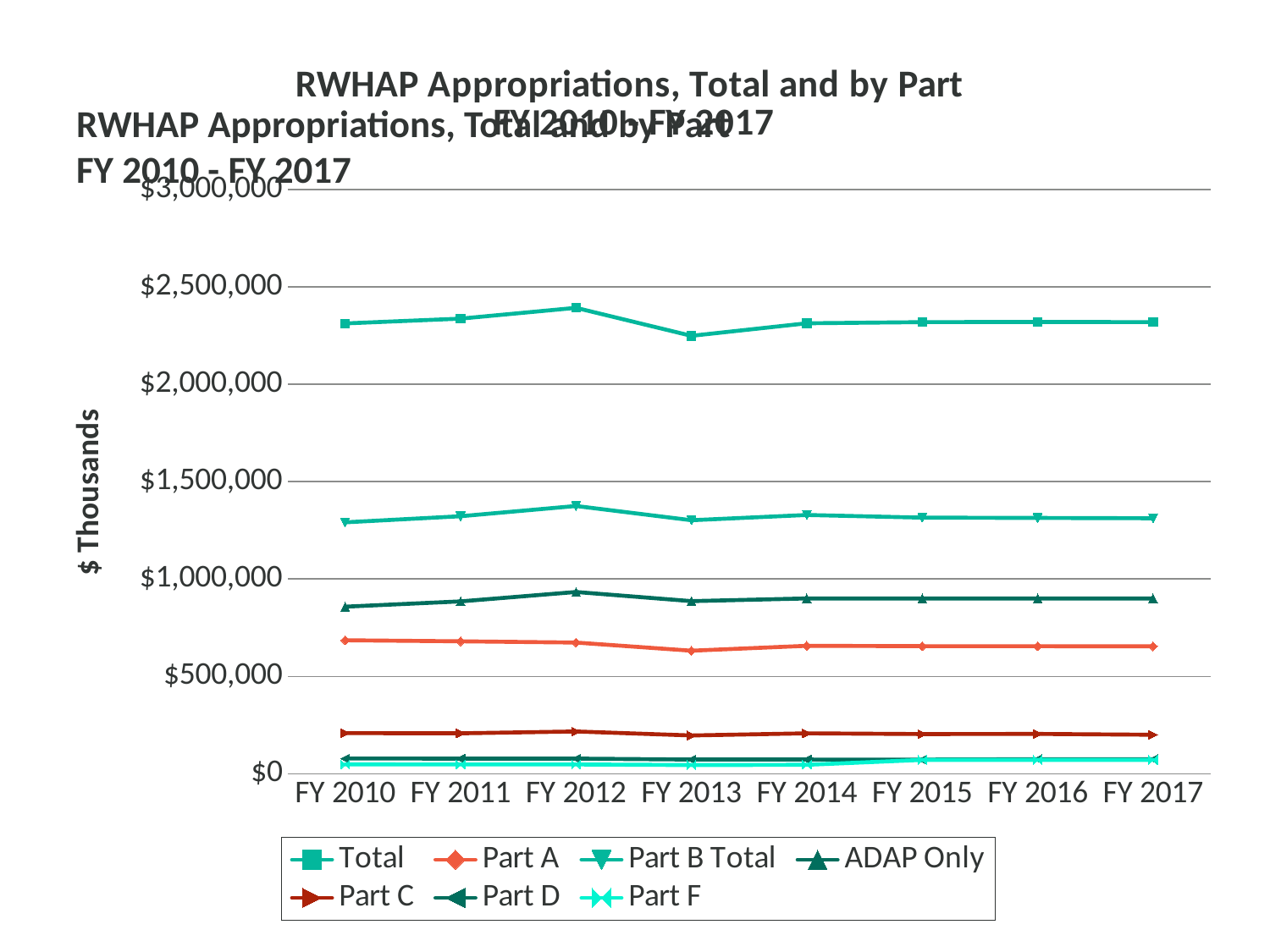
In which fiscal year is the Total series at its lowest? FY 2013 Which is larger in FY 2014, Part B Total or Part A? Part B Total Is the value for Part C in FY 2012 greater or less than $500,000? less Is the value for Total in FY 2010 greater or less than $2,000,000? greater Is the value for ADAP Only in FY 2012 greater or less than $1,000,000? less How many fiscal years are plotted along the x axis? 8 How many series does the legend list? 7 What is the label on the vertical axis? $ Thousands In which fiscal year is the Total series at its highest? FY 2012 What kind of chart is shown on the slide? line chart